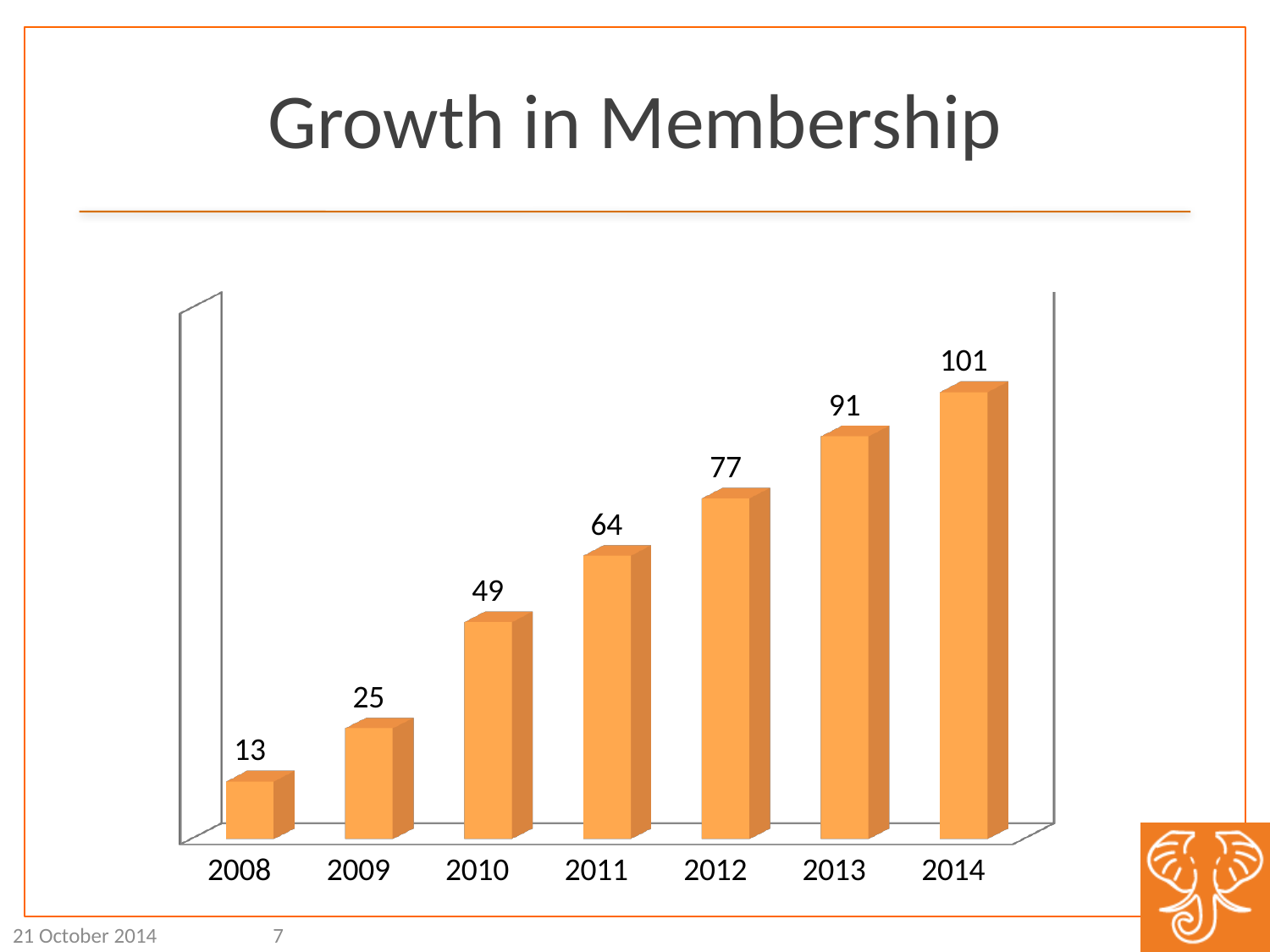
How many years are shown on the chart? 7 What is the membership value for 2010? 49 What is the difference in membership between 2014 and 2008? 88 Do the membership values rise or fall from 2008 to 2014? Rise What is the membership value for 2008? 13 What kind of chart is shown on the slide? Bar chart Which year has the lowest membership? 2008 What is the membership value for 2013? 91 Which year has a larger membership, 2009 or 2011? 2011 What is the title of the chart? Growth in Membership Which year has the highest membership? 2014 What is the difference in membership between 2012 and 2011? 13